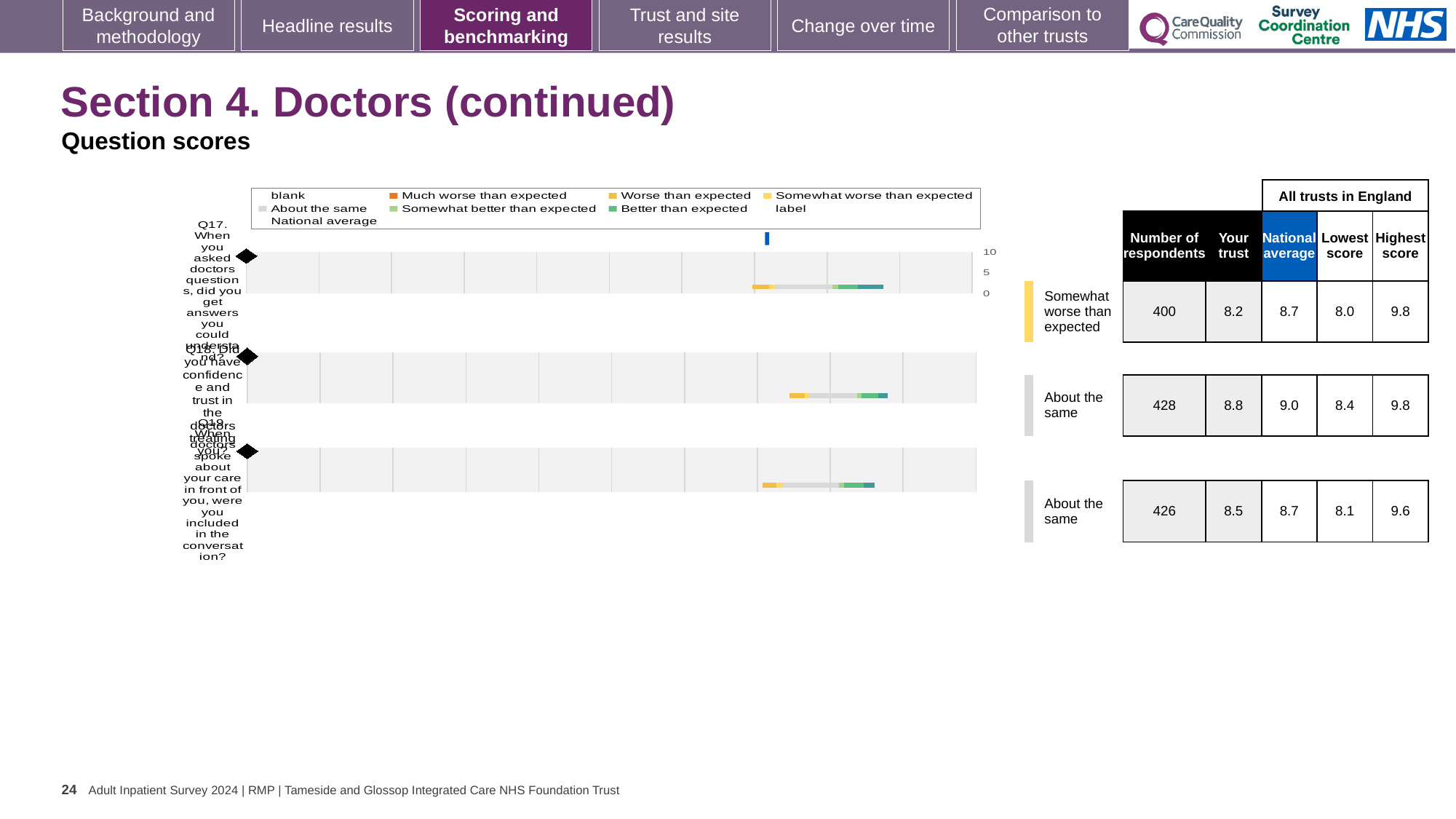
How many questions (rows) are plotted in the chart? 3 Which question has the highest 'Your trust' score? Q18 What kind of chart is used to show the question scores on this slide? Bar chart Which question has the lowest number of respondents? Q17 What is the national average score for Q18? 9.0 What is the lowest score across all trusts in England for Q18? 8.4 What is the difference between the national average and the 'Your trust' score for Q17? 0.5 For Q19, which is larger: the 'Your trust' score or the national average? National average How many respondents answered Q18 (Did you have confidence and trust in the doctors treating you)? 428 Which benchmark category is Q17 placed in? Somewhat worse than expected What is the 'Your trust' score for Q17 (When you asked doctors questions, did you get answers you could understand)? 8.2 What is the highest score across all trusts in England for Q19? 9.6